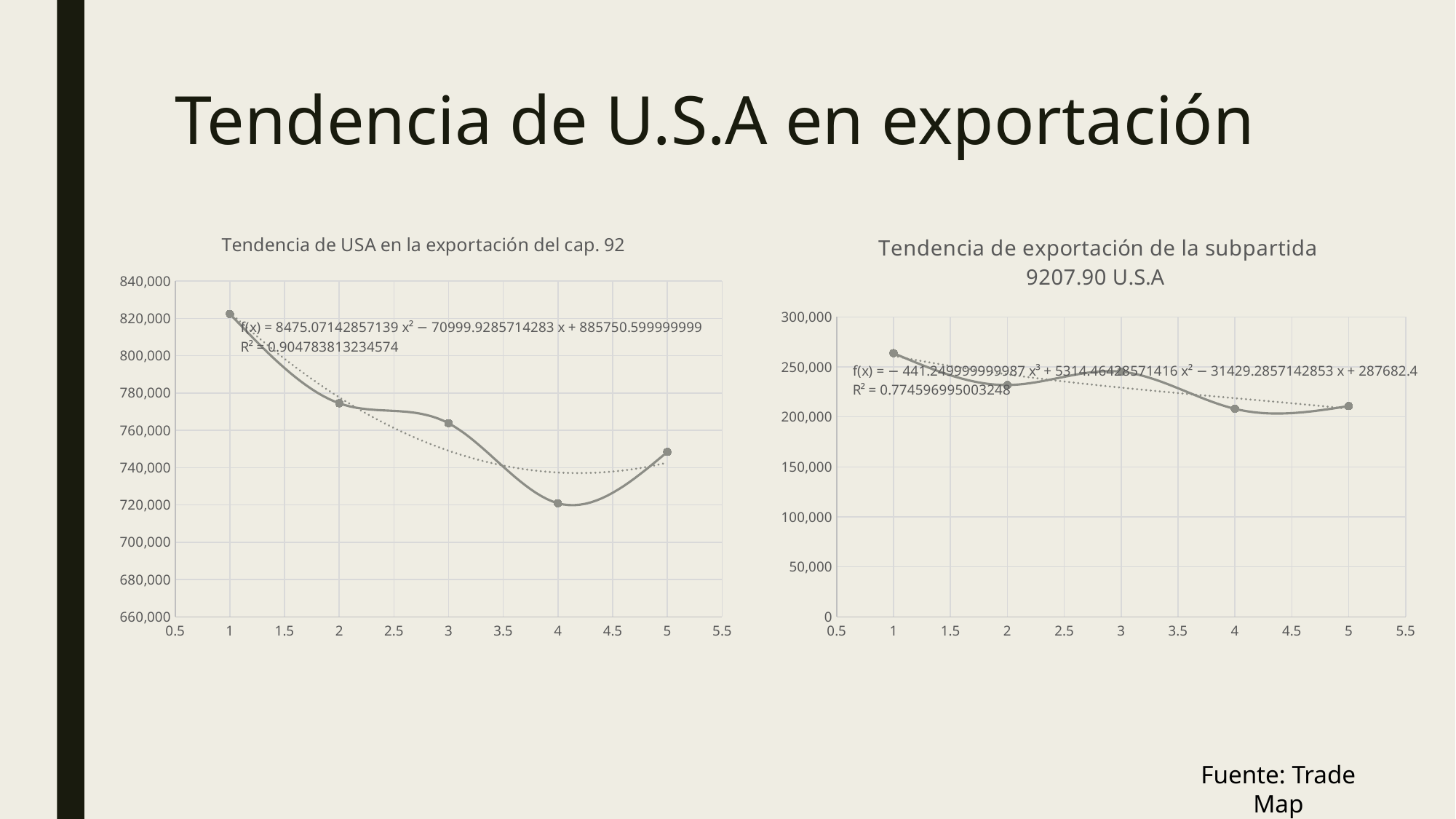
What kind of chart is the left chart, 'Tendencia de USA en la exportación del cap. 92'? line chart In the right chart, 'Tendencia de exportación de la subpartida 9207.90 U.S.A', at which x value is the plotted value highest? 1 In the left chart, 'Tendencia de USA en la exportación del cap. 92', at which x value is the plotted value highest? 1 In the left chart, 'Tendencia de USA en la exportación del cap. 92', is the value at x = 1 greater or less than 800,000? greater In the left chart, 'Tendencia de USA en la exportación del cap. 92', what R² value is shown for the trendline? 0.904783813234574 In the left chart, 'Tendencia de USA en la exportación del cap. 92', at which x value is the plotted value lowest? 4 In the left chart, 'Tendencia de USA en la exportación del cap. 92', how many data points are plotted? 5 In the right chart, 'Tendencia de exportación de la subpartida 9207.90 U.S.A', do the plotted values overall rise or fall from x = 1 to x = 5? fall In the right chart, 'Tendencia de exportación de la subpartida 9207.90 U.S.A', is the value at x = 1 greater or less than 250,000? greater In the left chart, 'Tendencia de USA en la exportación del cap. 92', which is larger, the value at x = 2 or the value at x = 5? x = 2 In the right chart, 'Tendencia de exportación de la subpartida 9207.90 U.S.A', is the value at x = 4 greater or less than 200,000? greater